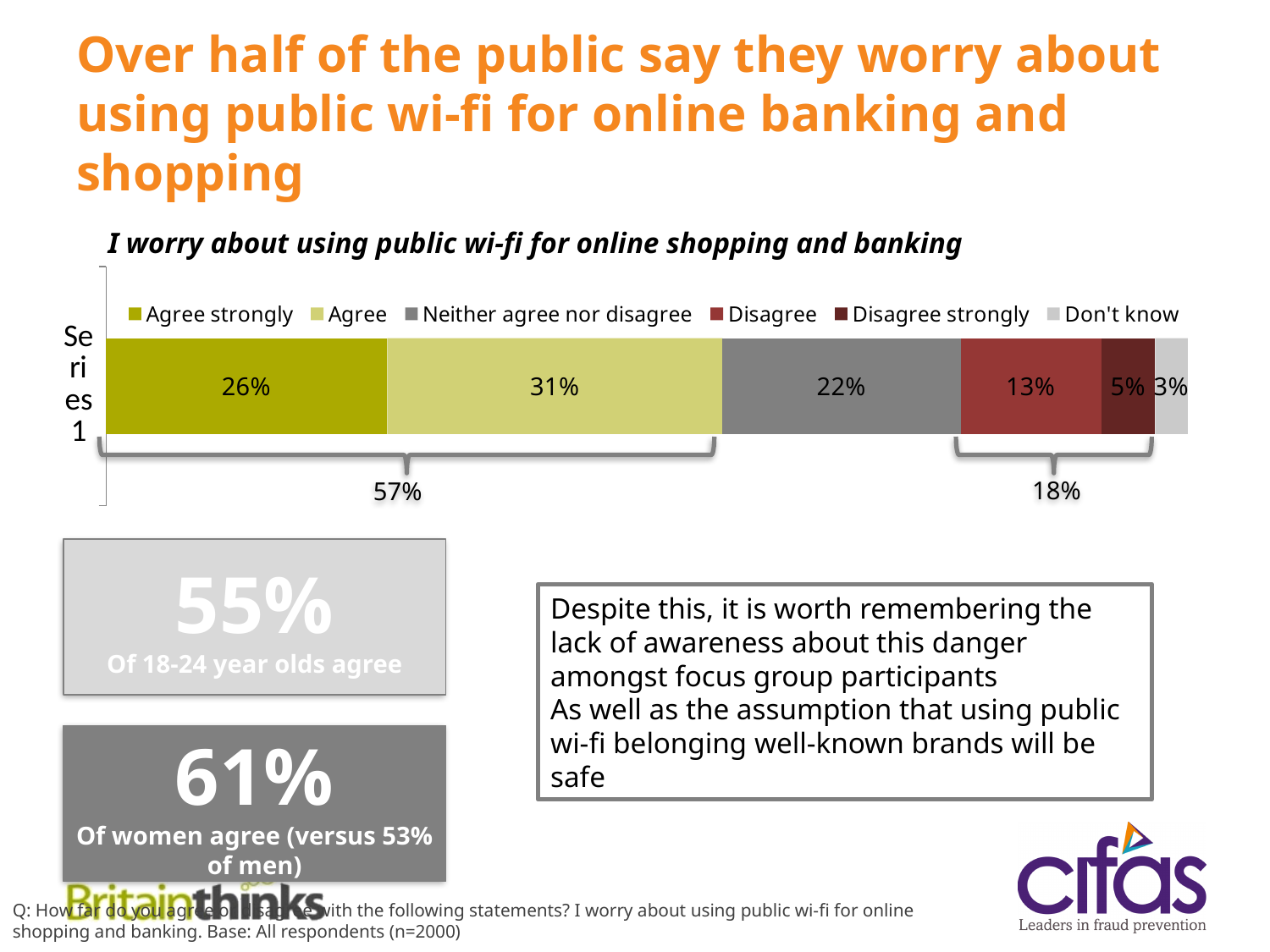
What percentage of respondents 'Agree strongly' that they worry about using public wi-fi for online shopping and banking? 26% What is the combined percentage of 'Agree strongly' and 'Agree' shown under the bracket? 57% How many series does the chart legend list? 6 What percentage of respondents answered 'Don't know'? 3% Which is larger, the 'Neither agree nor disagree' share or the 'Disagree' share? Neither agree nor disagree What percentage of respondents 'Neither agree nor disagree'? 22% What percentage of respondents 'Agree' with the statement about worrying about public wi-fi? 31% Which response category has the smallest share in the chart? Don't know What is the difference between the 'Agree' and 'Agree strongly' percentages? 5% What percentage of respondents 'Disagree' with the statement? 13% Which response category has the largest share in the chart? Agree What type of chart is used to show the responses? Stacked bar chart